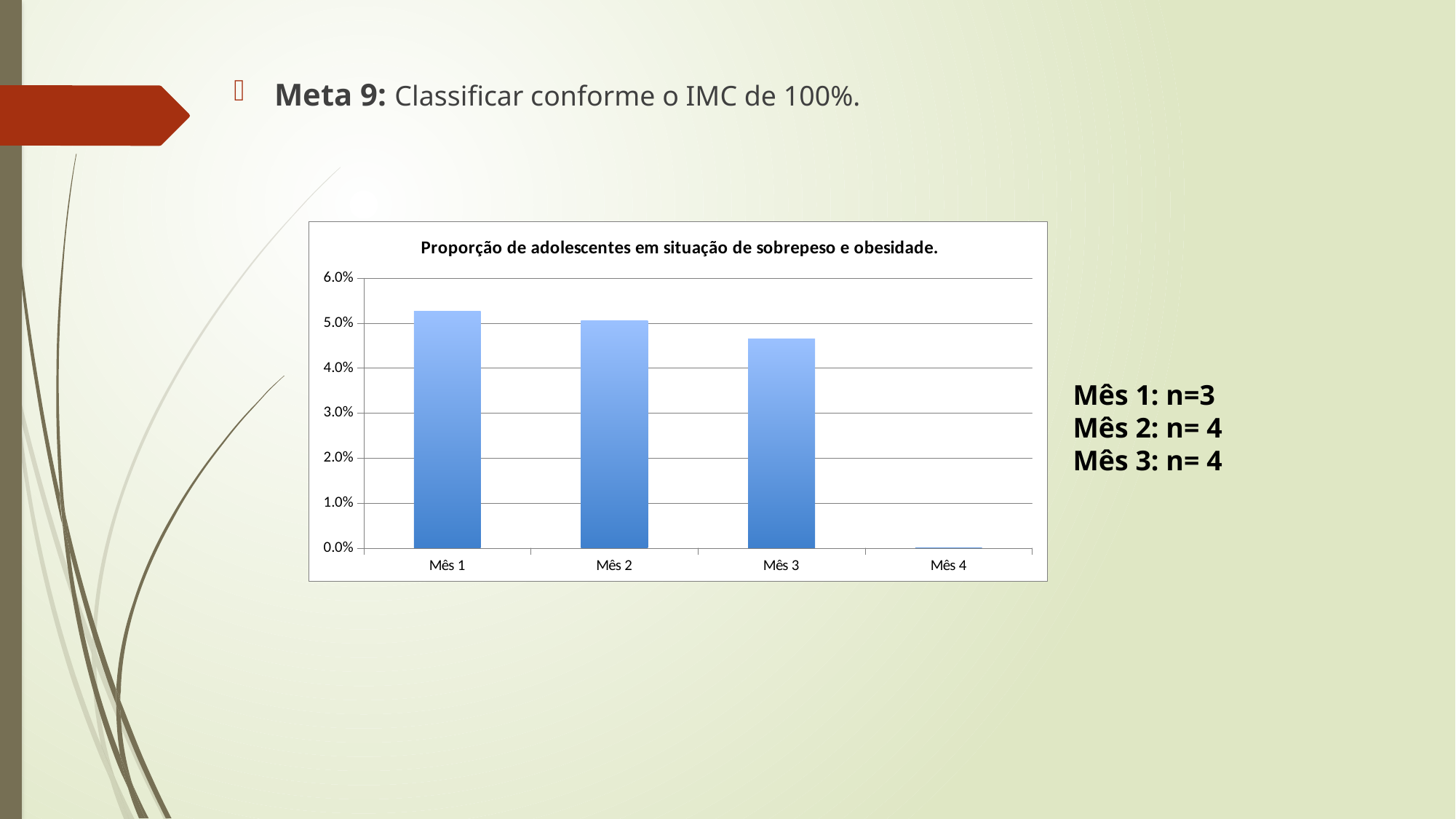
Is the value for Mês 3 greater or less than 5.0%? less Which month has the highest value in the chart? Mês 1 What is the title of the chart? Proporção de adolescentes em situação de sobrepeso e obesidade. Which month has the lowest value in the chart? Mês 4 Is the value for Mês 1 greater or less than 5.0%? greater Is the value for Mês 4 greater or less than 1.0%? less Do the values rise or fall from Mês 1 to Mês 4? fall What is the highest value shown on the y axis of the chart? 6.0% Which is larger, the value for Mês 1 or the value for Mês 3? Mês 1 How many categories are shown on the x axis of the chart? 4 What type of chart is shown on the slide? bar chart